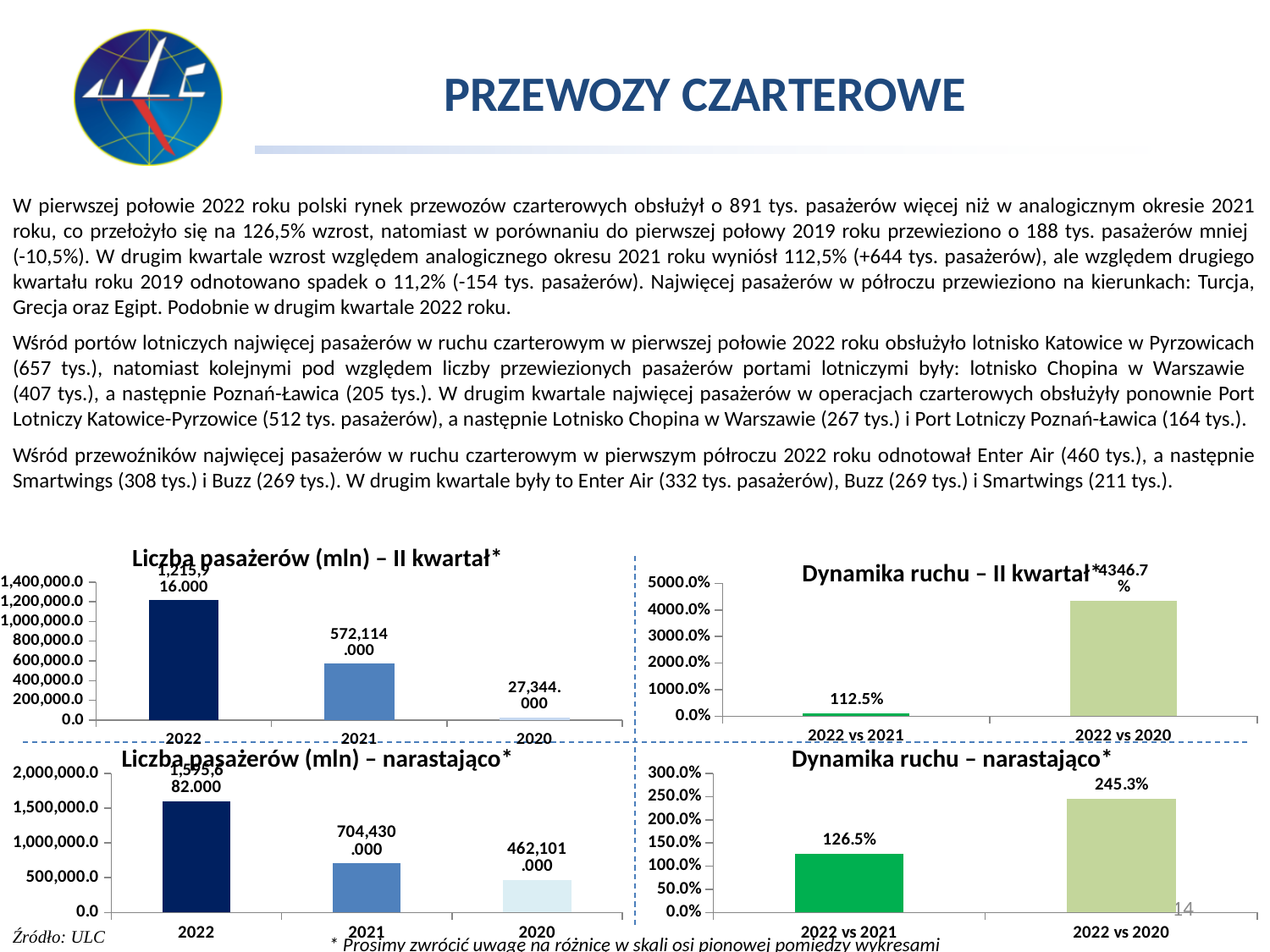
In the chart 'Liczba pasażerów (mln) – narastająco*', which year has the lowest value? 2020 In the chart 'Dynamika ruchu – II kwartał*', what is the value for 2022 vs 2020? 4346.7% In the chart 'Liczba pasażerów (mln) – II kwartał*', what is the value for 2020? 27,344.000 In the chart 'Liczba pasażerów (mln) – II kwartał*', which year has the highest value? 2022 In the chart 'Liczba pasażerów (mln) – II kwartał*', what is the difference between the 2021 and 2020 values? 544,770.000 In the chart 'Dynamika ruchu – narastająco*', what is the value for 2022 vs 2020? 245.3% In the chart 'Dynamika ruchu – II kwartał*', what is the value for 2022 vs 2021? 112.5% What type of chart is 'Dynamika ruchu – narastająco*'? Bar chart In the chart 'Liczba pasażerów (mln) – narastająco*', what is the value for 2021? 704,430.000 In the chart 'Liczba pasażerów (mln) – II kwartał*', what is the value for 2021? 572,114.000 In the chart 'Liczba pasażerów (mln) – narastająco*', what is the value for 2020? 462,101.000 In the chart 'Dynamika ruchu – narastająco*', what is the difference between the 2022 vs 2020 and 2022 vs 2021 values? 118.8%